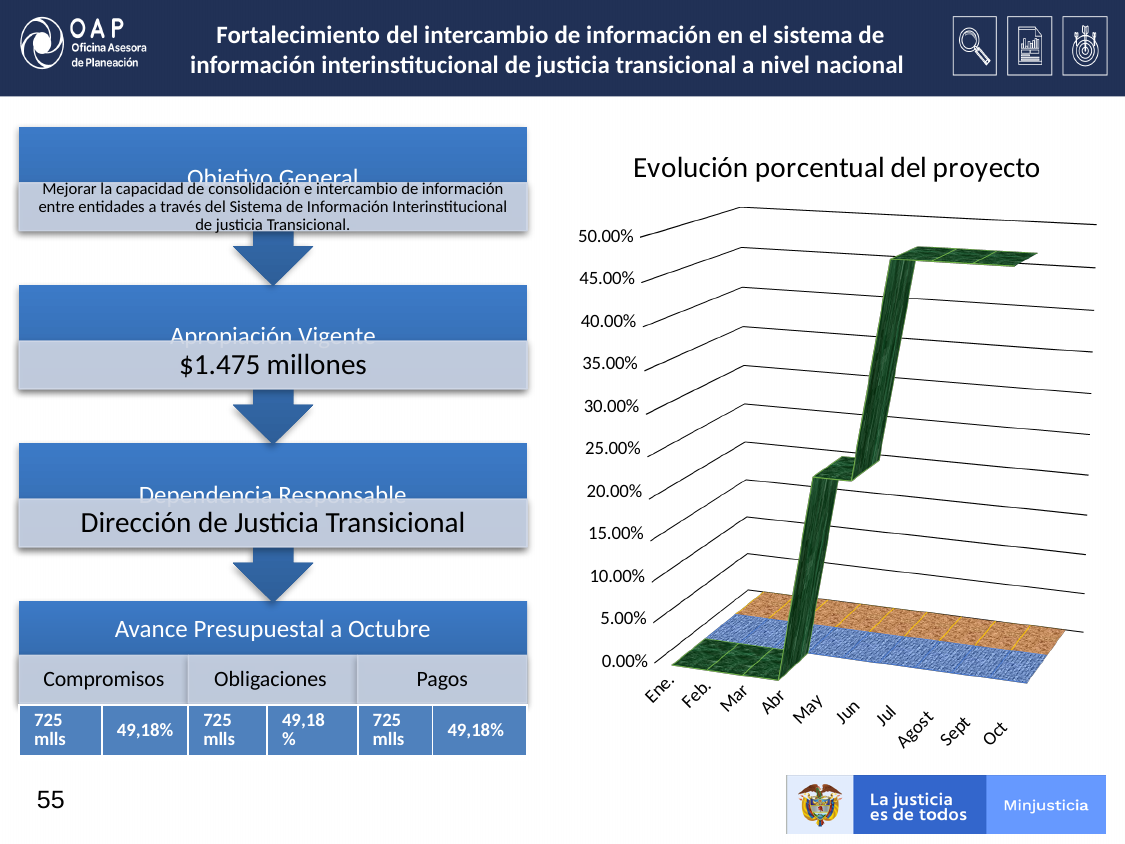
How many categories are shown on the x axis of the 'Evolución porcentual del proyecto' chart? 10 In the 'Evolución porcentual del proyecto' chart, do the values generally rise or fall from Ene. to Oct? rise In the 'Evolución porcentual del proyecto' chart, which is larger, the value for Abr or the value for Oct? Oct In the 'Evolución porcentual del proyecto' chart, is the value for Ene. greater or less than 5.00%? less What kind of chart is 'Evolución porcentual del proyecto'? line chart In the 'Evolución porcentual del proyecto' chart, is the value for Sept greater or less than 30.00%? greater In the 'Evolución porcentual del proyecto' chart, which is larger, the value for Mar or the value for Jul? Jul In the 'Evolución porcentual del proyecto' chart, is the value for Oct greater or less than 40.00%? greater What is the title of the chart on the right side of the slide? Evolución porcentual del proyecto What is the highest tick label on the vertical axis of the 'Evolución porcentual del proyecto' chart? 50.00%